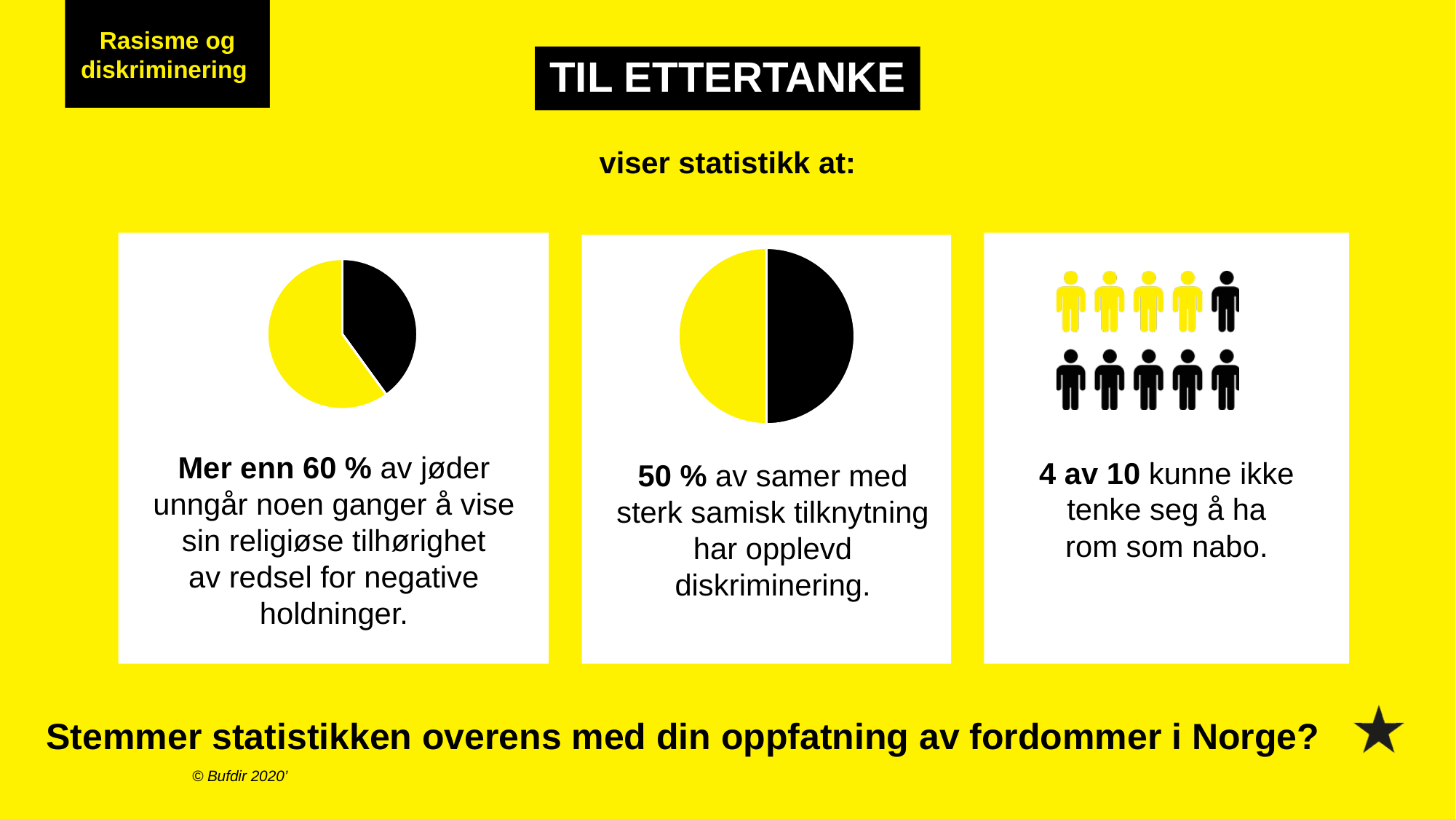
In the middle pie chart, are the yellow and black slices equal in size? yes What kind of chart is shown in the middle panel about samer? pie chart In the middle pie chart, what share of samer med sterk samisk tilknytning har opplevd diskriminering? 50 % In the right panel pictogram, how many person figures are black? 6 In the left pie chart, is the yellow slice greater or less than 50 %? greater In the right panel pictogram, how many person figures are yellow? 4 What kind of chart is shown in the left panel about jøder? pie chart In the right panel pictogram, how many person figures are shown in total? 10 In the left pie chart, which slice is larger, the yellow or the black one? yellow According to the left panel, what share of jøder unngår noen ganger å vise sin religiøse tilhørighet? Mer enn 60 % According to the right panel, how many out of 10 kunne ikke tenke seg å ha rom som nabo? 4 av 10 How many white statistic panels are shown on the slide? 3